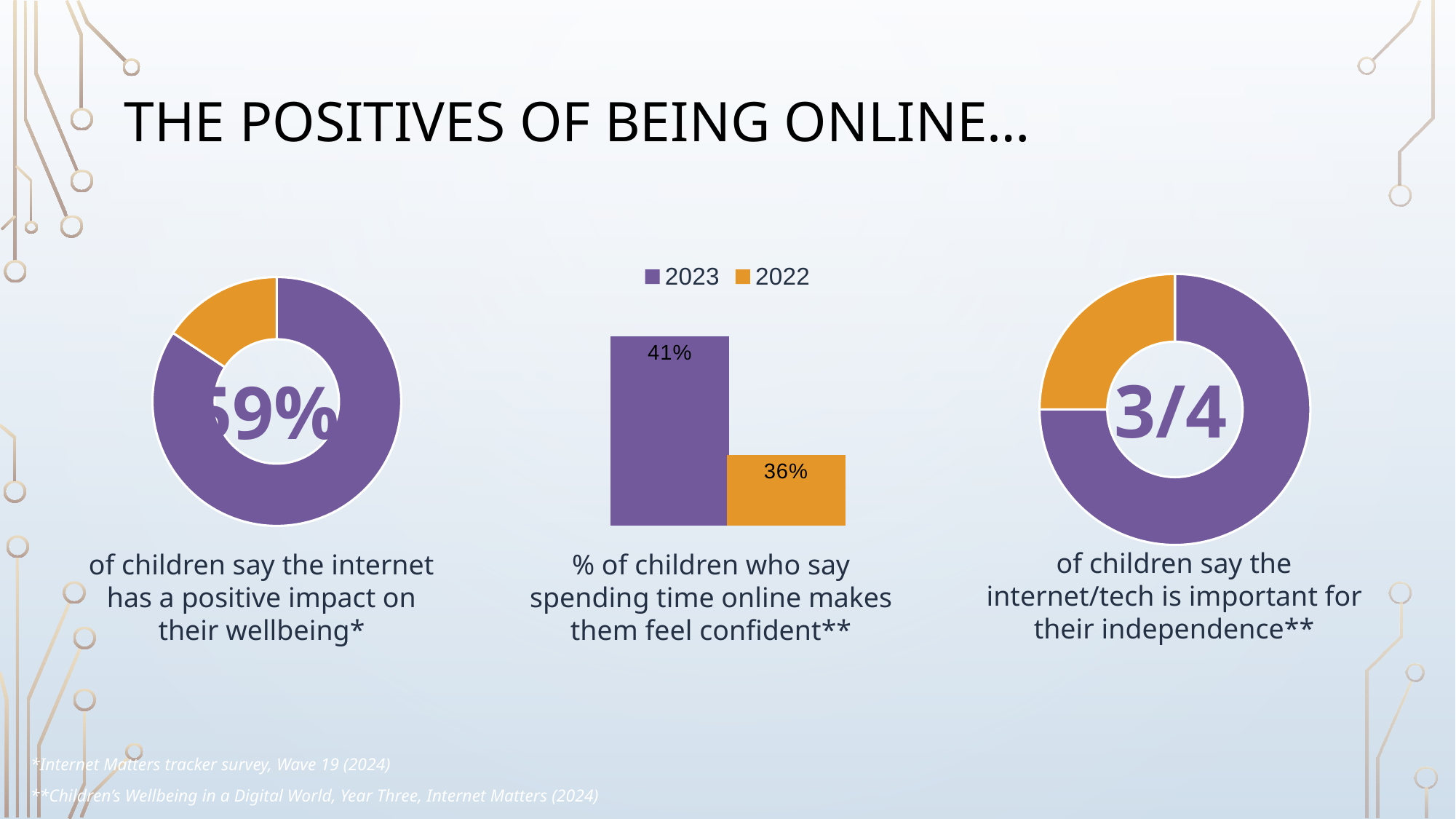
What value is printed in the centre of the right-hand chart about the internet/tech being important for independence? 3/4 On the middle chart, what is the difference between the 2023 and 2022 values? 5% On the left-hand chart about the internet having a positive impact on wellbeing, is the purple share greater or less than 50%? greater On the middle chart, which year has the lowest value? 2022 How many charts are shown on the slide? 3 What kind of chart is the middle chart on the slide? bar chart What kind of chart is the right-hand chart about the internet/tech being important for independence? doughnut chart How many series does the legend of the middle chart list? 2 On the middle chart, which year has the higher value, 2023 or 2022? 2023 On the middle chart about children who say spending time online makes them feel confident, what is the value for 2023? 41% On the middle chart about children who say spending time online makes them feel confident, what is the value for 2022? 36% On the middle chart, which colour represents 2022? orange